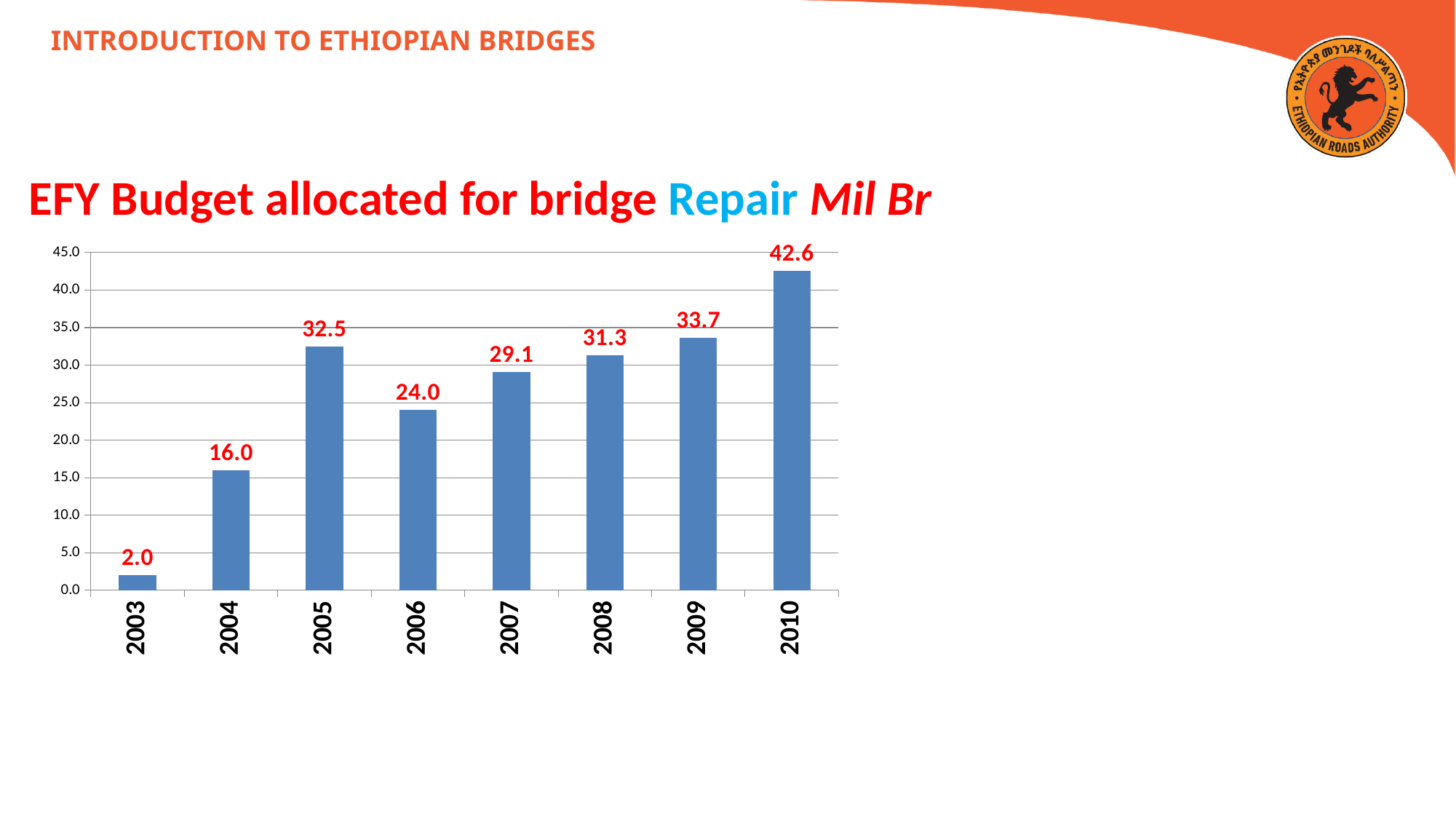
What is the difference between the budget for 2010 and the budget for 2009? 8.9 How many years are shown on the chart? 8 What kind of chart is shown on the slide? Bar chart What is the difference between the budget for 2005 and the budget for 2006? 8.5 Is the value for 2004 greater or less than 20.0? less What is the budget allocated for bridge repair in 2003? 2.0 What is the title of the chart on the slide? EFY Budget allocated for bridge Repair Mil Br What is the budget allocated for bridge repair in 2008? 31.3 Which year has a larger budget, 2006 or 2007? 2007 What is the budget allocated for bridge repair in 2005? 32.5 Which year has the highest budget allocated for bridge repair? 2010 Which year has the lowest budget allocated for bridge repair? 2003